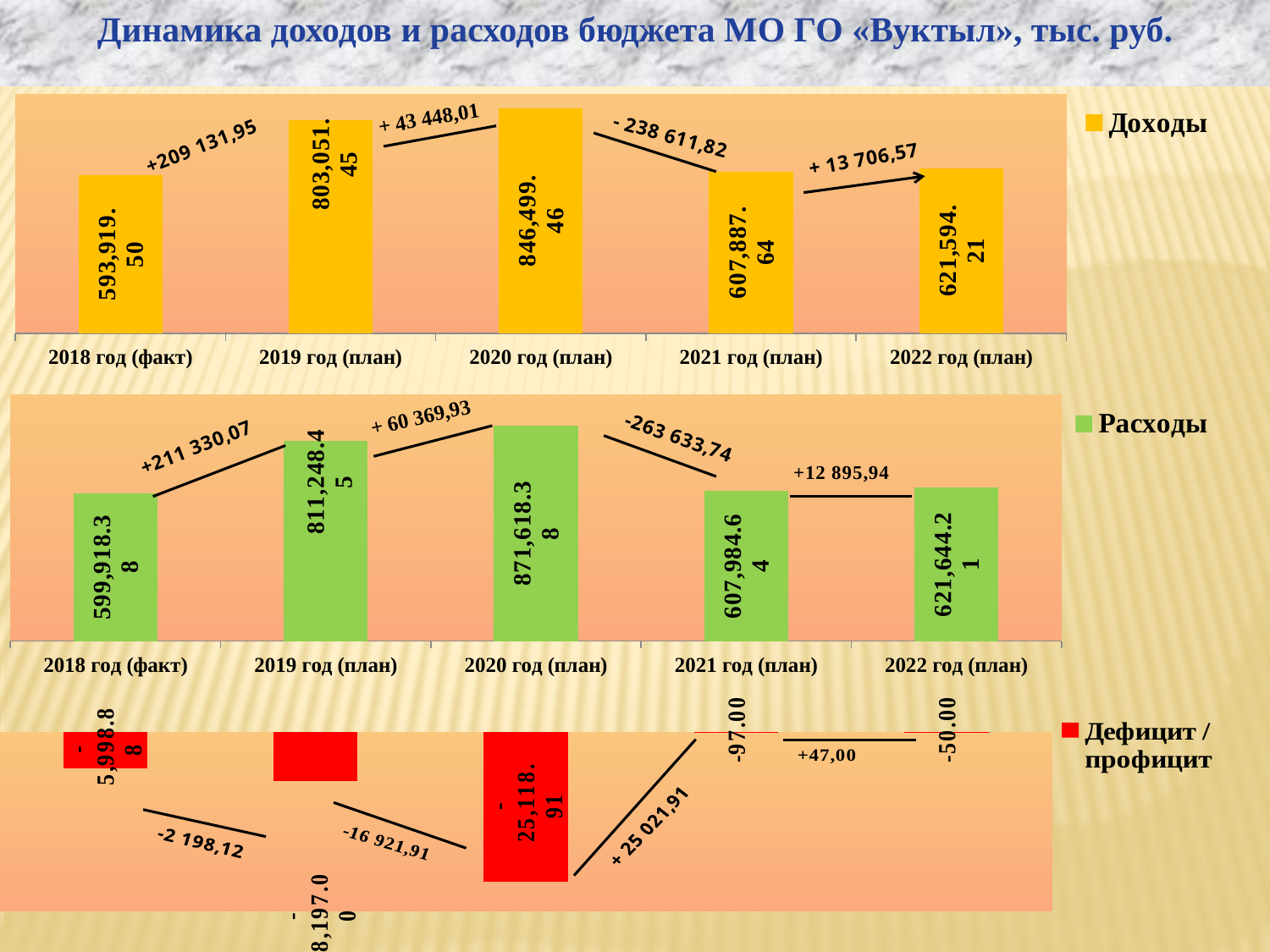
What kind of chart is the Доходы chart? bar chart In the Доходы chart, which year has the highest value? 2020 год (план) In the Доходы chart, what change is labelled between 2019 год (план) and 2020 год (план)? + 43 448,01 In the Дефицит / профицит chart, what is the value for 2020 год (план)? -25,118.91 In the Доходы chart, which year has the lowest value? 2018 год (факт) In the Доходы chart, what is the value for 2018 год (факт)? 593,919.50 In the Расходы chart, which year has the highest value? 2020 год (план) In the Дефицит / профицит chart, what is the value for 2021 год (план)? -97.00 In the Расходы chart, what is the value for 2022 год (план)? 621,644.21 In the Доходы chart, what is the value for 2020 год (план)? 846,499.46 In the Расходы chart, what is the value for 2019 год (план)? 811,248.45 How many categories (years) does the Расходы chart show? 5